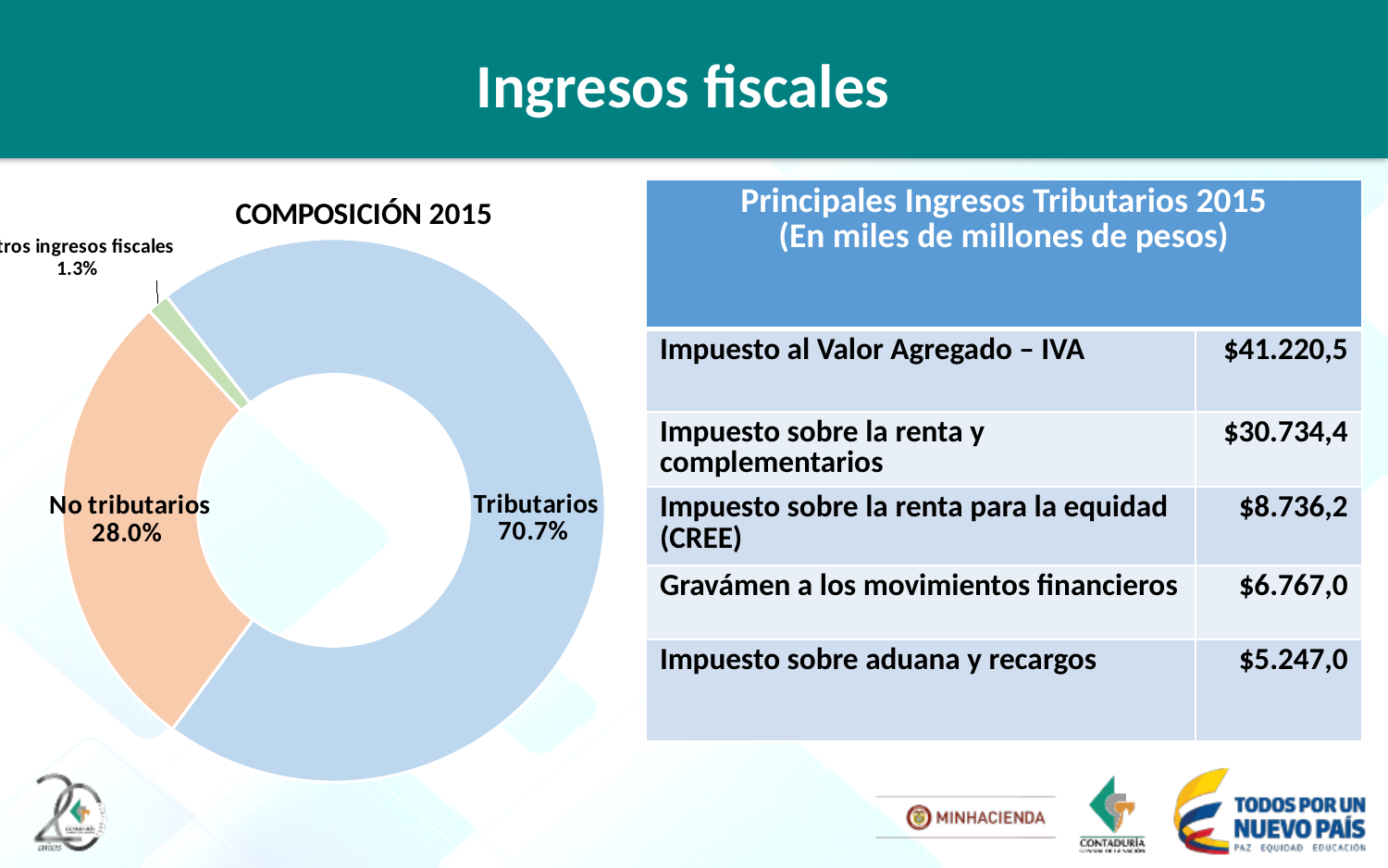
What kind of chart is shown under the title COMPOSICIÓN 2015? pie chart (doughnut) What colour is the Tributarios slice in the COMPOSICIÓN 2015 chart? light blue In the COMPOSICIÓN 2015 chart, is the share for Tributarios greater or less than 50%? greater In the COMPOSICIÓN 2015 chart, what do Tributarios and No tributarios add up to? 98.7% In the COMPOSICIÓN 2015 chart, which is larger: Tributarios or No tributarios? Tributarios In the COMPOSICIÓN 2015 chart, how many percentage points larger is Tributarios than No tributarios? 42.7 percentage points Which slice is the smallest in the COMPOSICIÓN 2015 chart? the green slice (1.3%) How many slices does the COMPOSICIÓN 2015 chart have? 3 In the COMPOSICIÓN 2015 chart, what percentage is shown for No tributarios? 28.0% In the COMPOSICIÓN 2015 chart, what percentage is shown for the smallest slice (the green one)? 1.3% Which category has the largest share in the COMPOSICIÓN 2015 chart? Tributarios In the COMPOSICIÓN 2015 chart, what percentage is shown for Tributarios? 70.7%